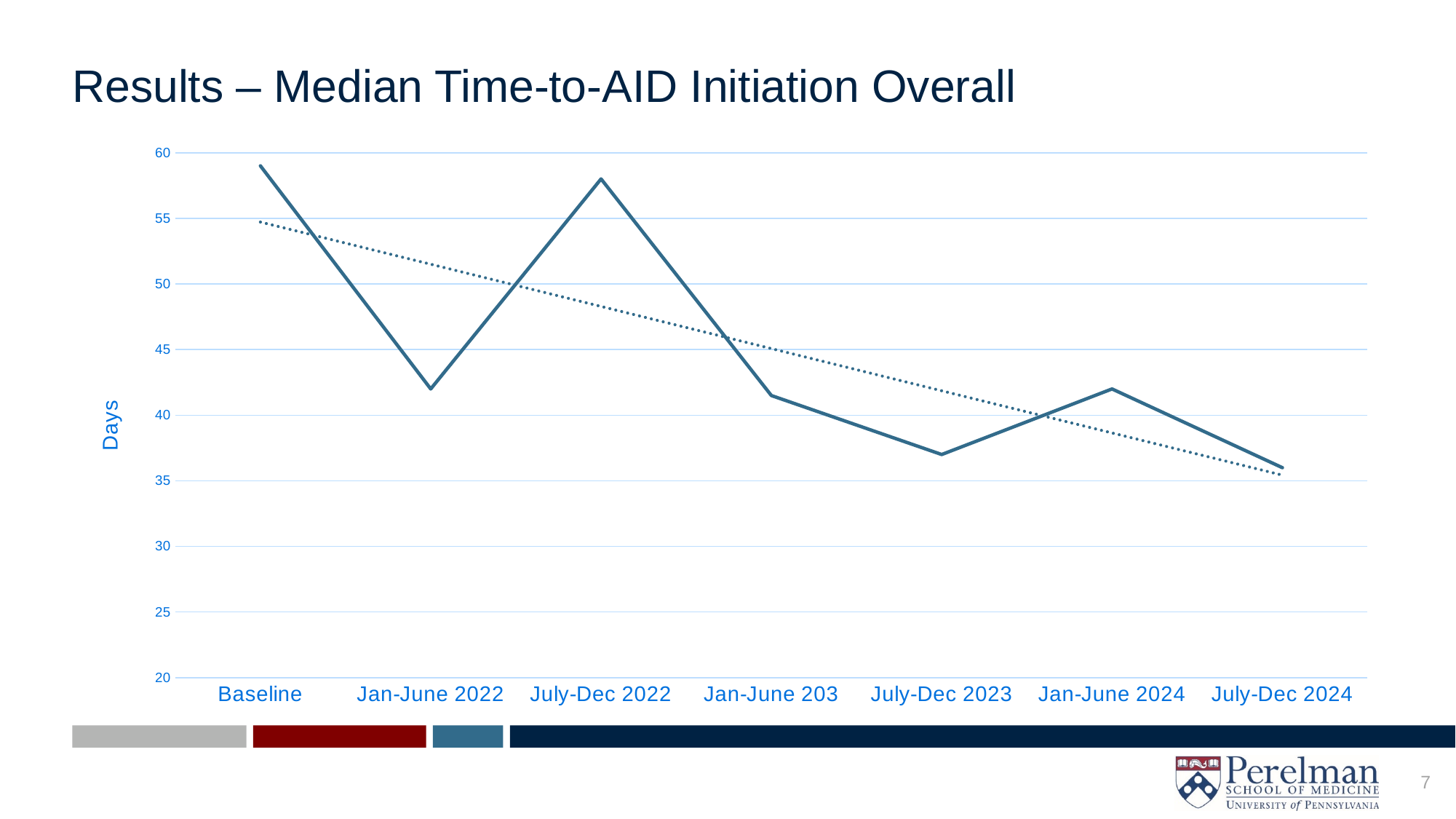
What is the title of the slide containing the chart? Results – Median Time-to-AID Initiation Overall Is the value for July-Dec 2023 greater or less than 40? less Overall, do the values rise or fall from Baseline to July-Dec 2024? fall What is the label of the y axis? Days Is the value for Jan-June 2024 greater or less than 40? greater Is the value for Baseline greater or less than 55? greater What kind of chart is shown on the slide? line chart How many time periods are plotted along the x axis? 7 Which is larger, the value for Baseline or the value for Jan-June 2022? Baseline